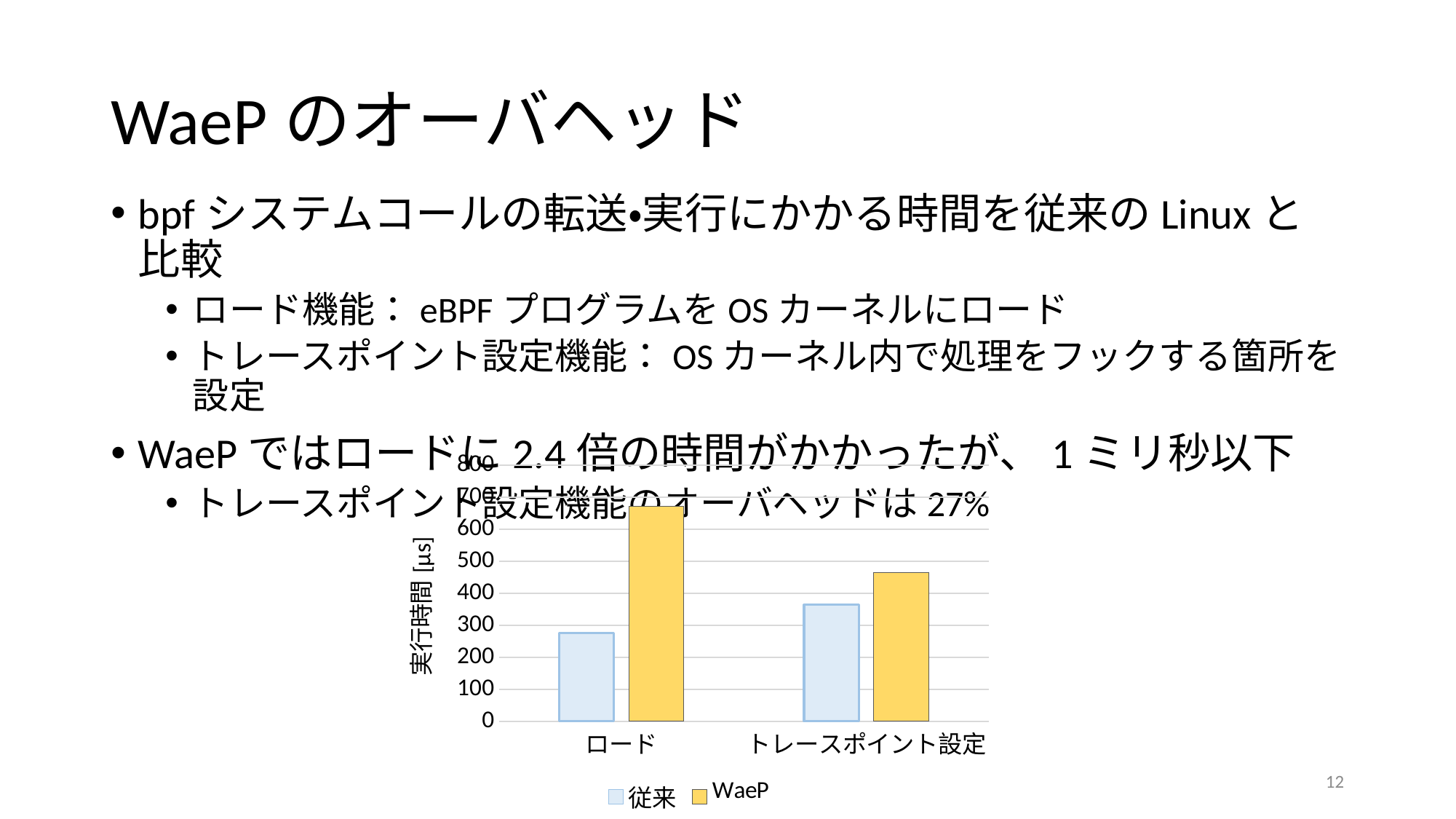
For トレースポイント設定, which series has the larger value, 従来 or WaeP? WaeP What are the two series named in the chart's legend? 従来, WaeP Is the value for WaeP in the トレースポイント設定 category greater or less than 500? less For ロード, which series has the larger value, 従来 or WaeP? WaeP What is the label of the chart's vertical axis? 実行時間 [µs] Is the value for 従来 in the ロード category greater or less than 300? less Is the value for WaeP in the ロード category greater or less than 600? greater Which bar in the chart is the tallest? WaeP for ロード How many series does the chart's legend list? 2 Which bar in the chart is the shortest? 従来 for ロード How many categories are shown on the x axis of the chart? 2 What kind of chart is shown on the slide? bar chart